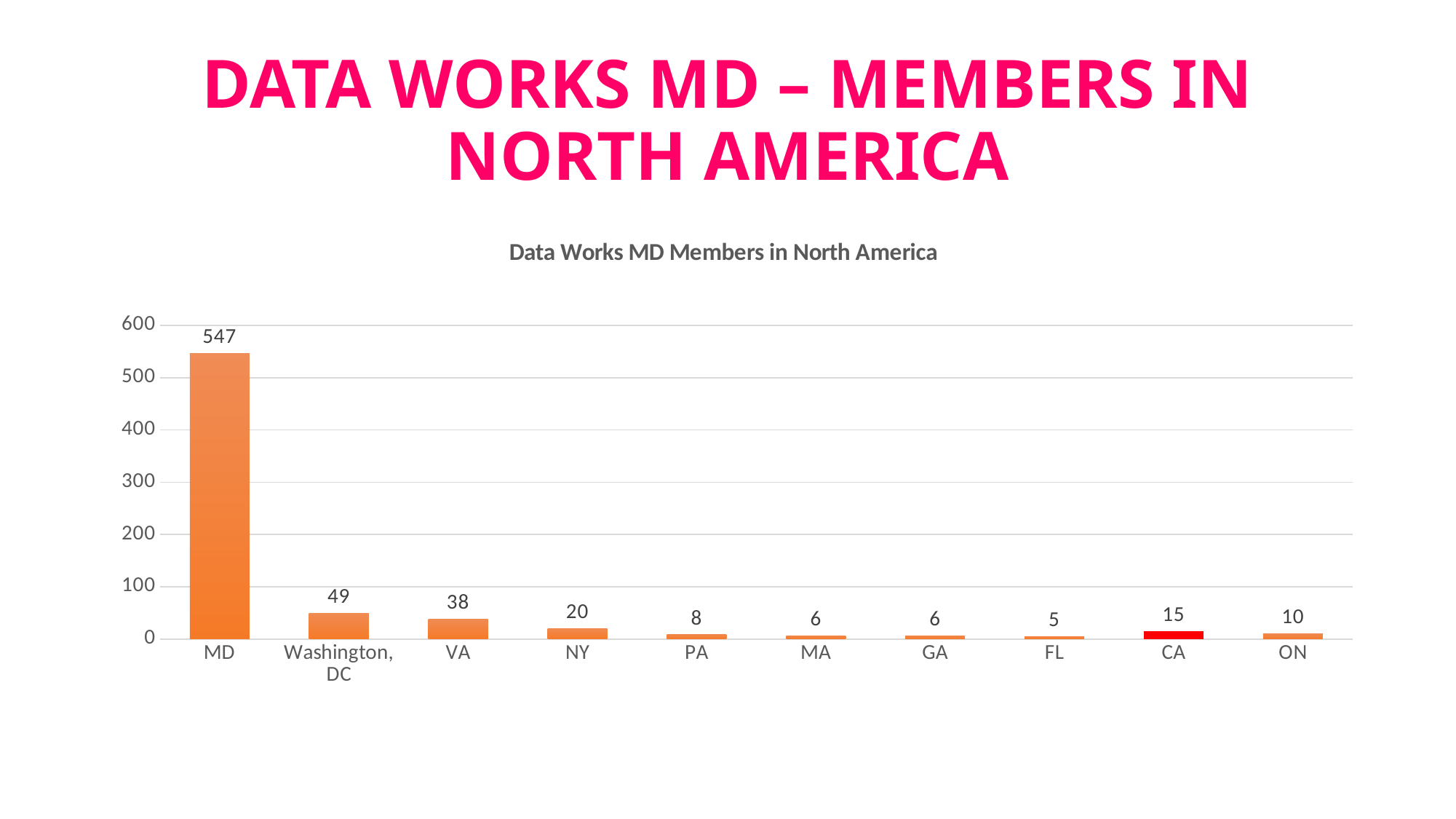
What is the value for Washington, DC? 49 What is the difference between the values for VA and NY? 18 Which category has the lowest value? FL What kind of chart is shown on the slide? Bar chart What is the title of the chart? Data Works MD Members in North America What is the value for MD? 547 What is the value for CA? 15 What is the difference between the values for MD and Washington, DC? 498 How many categories are shown on the x axis? 10 Which is larger, the value for CA or the value for ON? CA Which category has the highest value? MD What is the value for ON? 10